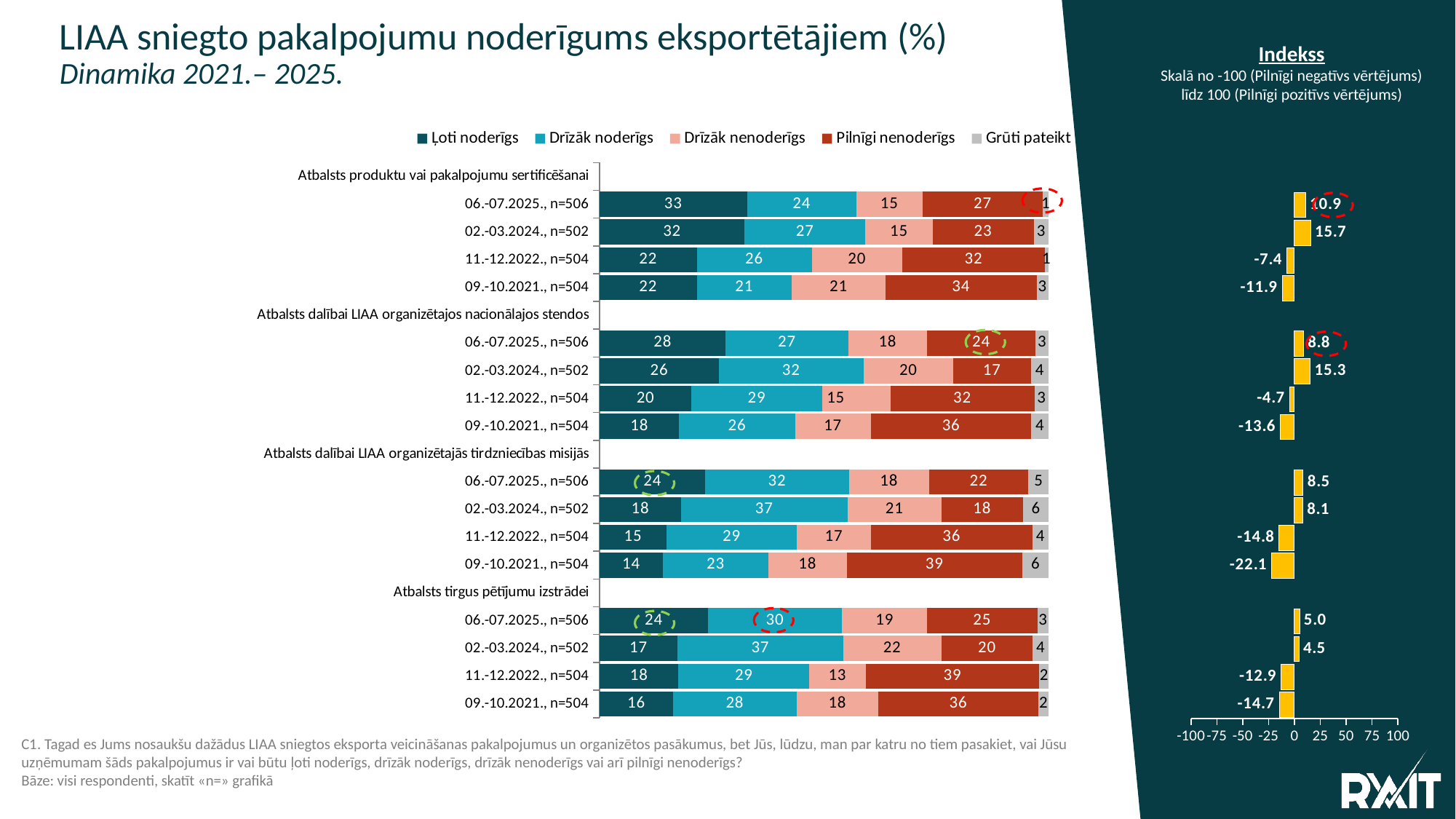
In the stacked bar chart, what is the "Pilnīgi nenoderīgs" value for "Atbalsts tirgus pētījumu izstrādei" in 11.-12.2022? 39 In the stacked bar chart, what is the "Ļoti noderīgs" value for "Atbalsts produktu vai pakalpojumu sertificēšanai" in 06.-07.2025? 33 In the Indekss chart, which bar has the highest index value? 02.-03.2024 for Atbalsts produktu vai pakalpojumu sertificēšanai (15.7) What kind of chart is the main chart on the left of the slide? Stacked bar chart In the stacked bar chart, what is the total of the 06.-07.2025 bar for "Atbalsts produktu vai pakalpojumu sertificēšanai"? 100 How many series does the legend of the stacked bar chart list? 5 What is the title of the slide's main chart? LIAA sniegto pakalpojumu noderīgums eksportētājiem (%) In the stacked bar chart, for "Atbalsts tirgus pētījumu izstrādei", is the "Drīzāk noderīgs" value larger in 02.-03.2024 or in 06.-07.2025? 02.-03.2024 In the stacked bar chart, what is the difference in the "Ļoti noderīgs" value for "Atbalsts produktu vai pakalpojumu sertificēšanai" between 06.-07.2025 and 09.-10.2021? 11 In the Indekss chart, what is the index value for "Atbalsts dalībai LIAA organizētajās tirdzniecības misijās" in 09.-10.2021? -22.1 In the Indekss chart, does the index for "Atbalsts tirgus pētījumu izstrādei" rise or fall from 09.-10.2021 to 06.-07.2025? Rises In the Indekss chart, which bar has the lowest index value? 09.-10.2021 for Atbalsts dalībai LIAA organizētajās tirdzniecības misijās (-22.1)